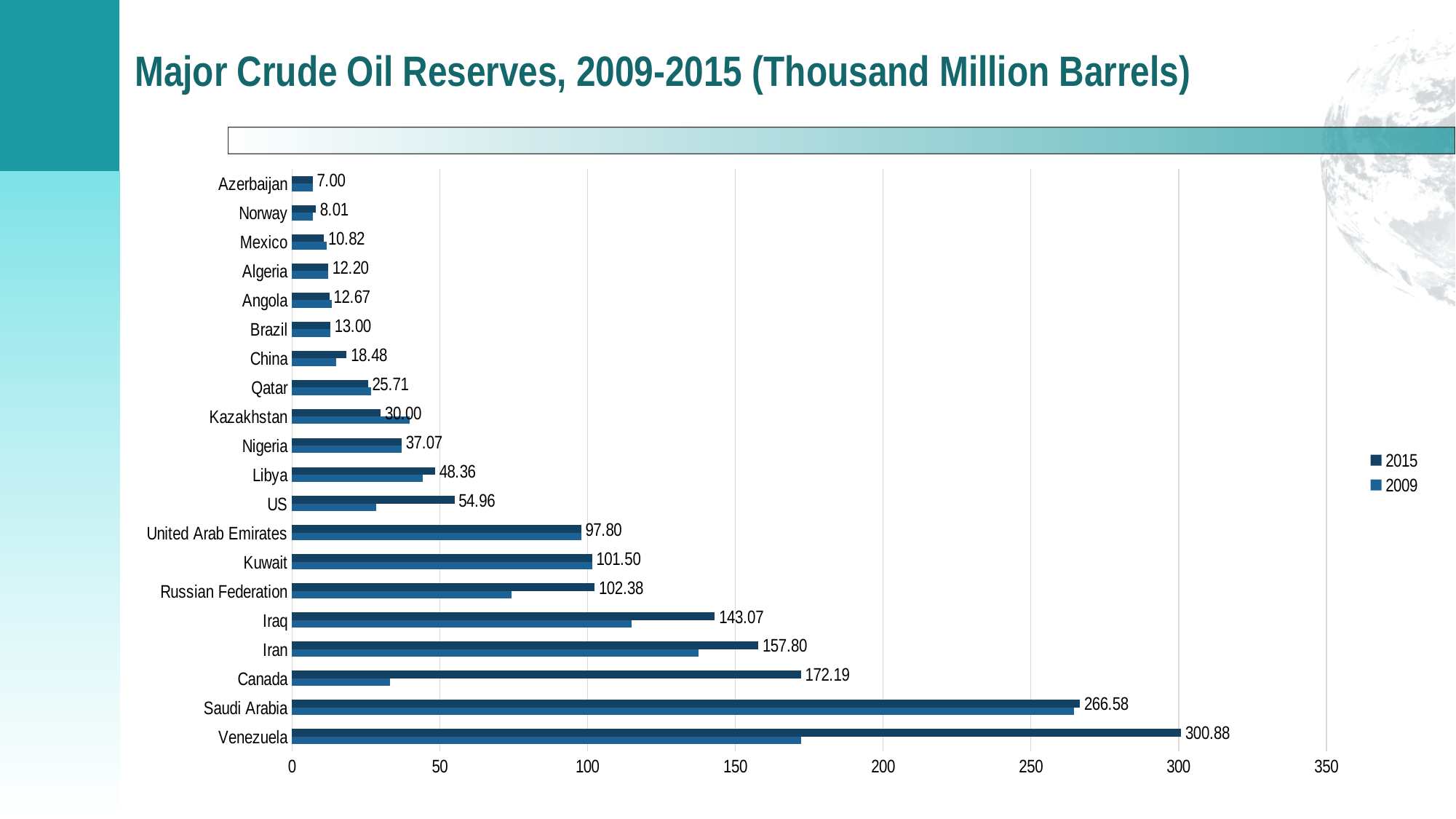
How many countries are shown on the chart? 20 Is the 2009 value for Canada greater or less than 50? less How many series does the legend list? 2 What is the 2015 value for Canada? 172.19 What kind of chart is shown on the slide? Bar chart Which has the larger 2015 value, Iraq or Iran? Iran Which country has the highest 2015 value? Venezuela What is the 2015 value for Kazakhstan? 30.00 Is the 2009 value for Venezuela greater or less than 150? greater What is the 2015 value for Venezuela? 300.88 What is the difference between the 2015 values for Venezuela and Saudi Arabia? 34.30 Which country has the lowest 2015 value? Azerbaijan